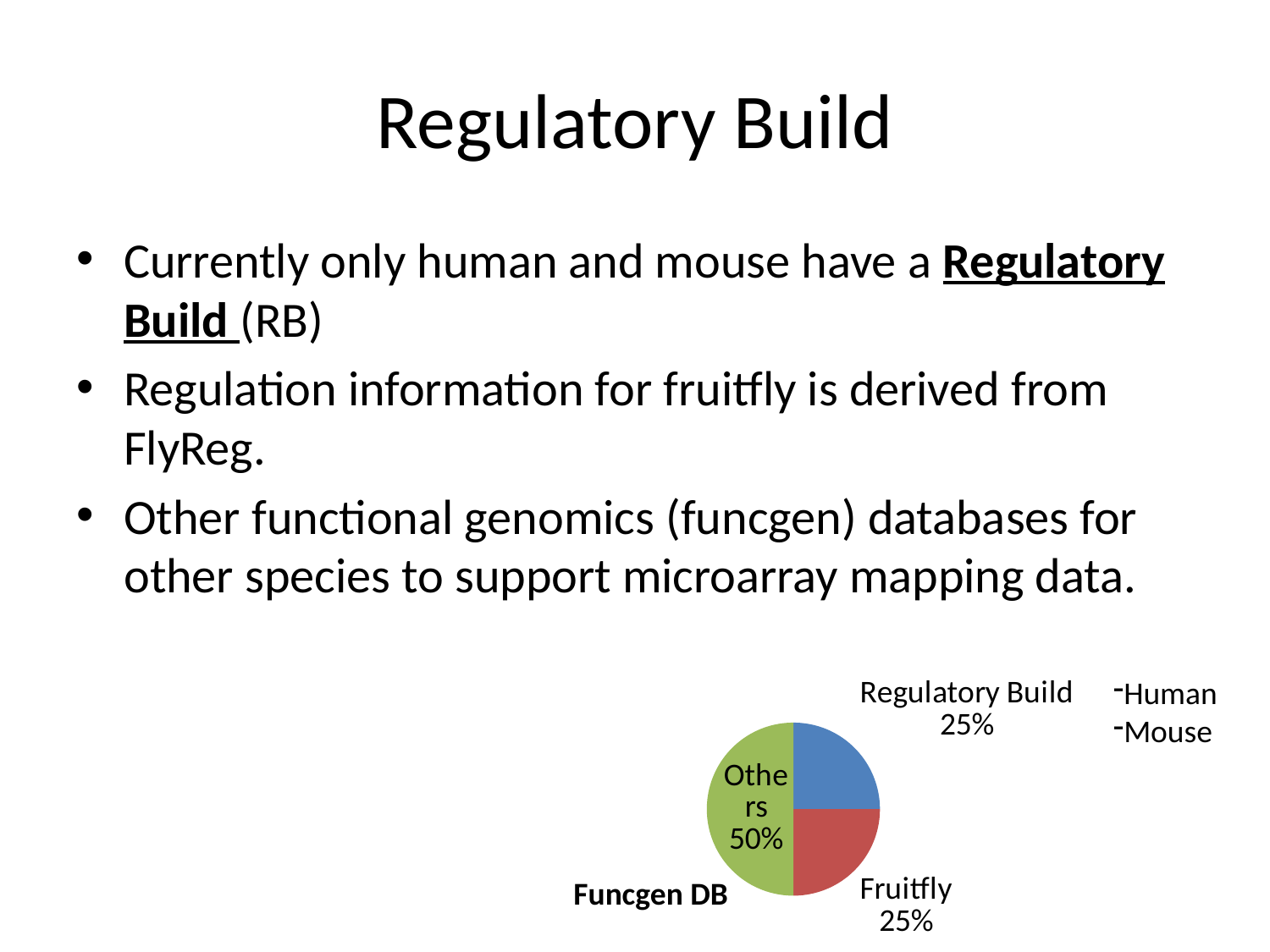
What share of the pie does Regulatory Build take? 25% What colour is the Others slice of the pie? green What is the difference between the share for Others and the share for Fruitfly? 25% What is the combined share of Regulatory Build and Fruitfly? 50% What share of the pie does Fruitfly take? 25% Which is larger, the share for Others or the share for Regulatory Build? Others What share of the pie does Others take? 50% How many slices does the pie chart have? 3 What kind of chart is shown on the slide? pie chart Which slice of the pie is the largest? Others What is the title of the pie chart? Funcgen DB